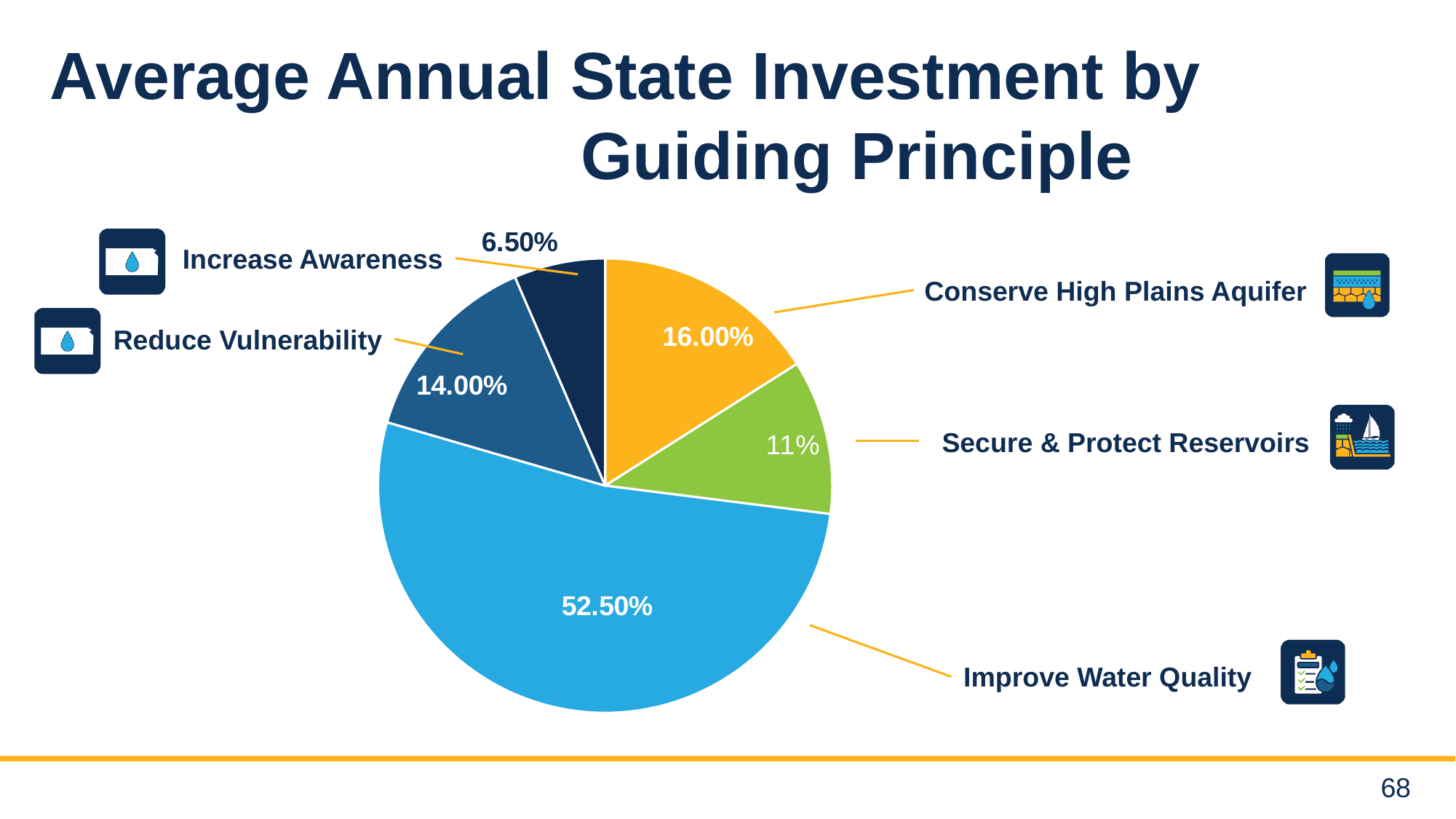
What is the title of the chart on the slide? Average Annual State Investment by Guiding Principle Which guiding principle receives the smallest share of average annual state investment? Increase Awareness Which receives a larger share: Conserve High Plains Aquifer or Reduce Vulnerability? Conserve High Plains Aquifer How many guiding principles (slices) are shown in the pie chart? 5 What share of average annual state investment goes to Increase Awareness? 6.50% What kind of chart is shown on the slide? Pie chart What is the difference in percentage points between Improve Water Quality and Conserve High Plains Aquifer? 36.50% What share of average annual state investment goes to Secure & Protect Reservoirs? 11% What share of average annual state investment goes to Improve Water Quality? 52.50% What share of average annual state investment goes to Reduce Vulnerability? 14.00% Which guiding principle receives the largest share of average annual state investment? Improve Water Quality What share of average annual state investment goes to Conserve High Plains Aquifer? 16.00%